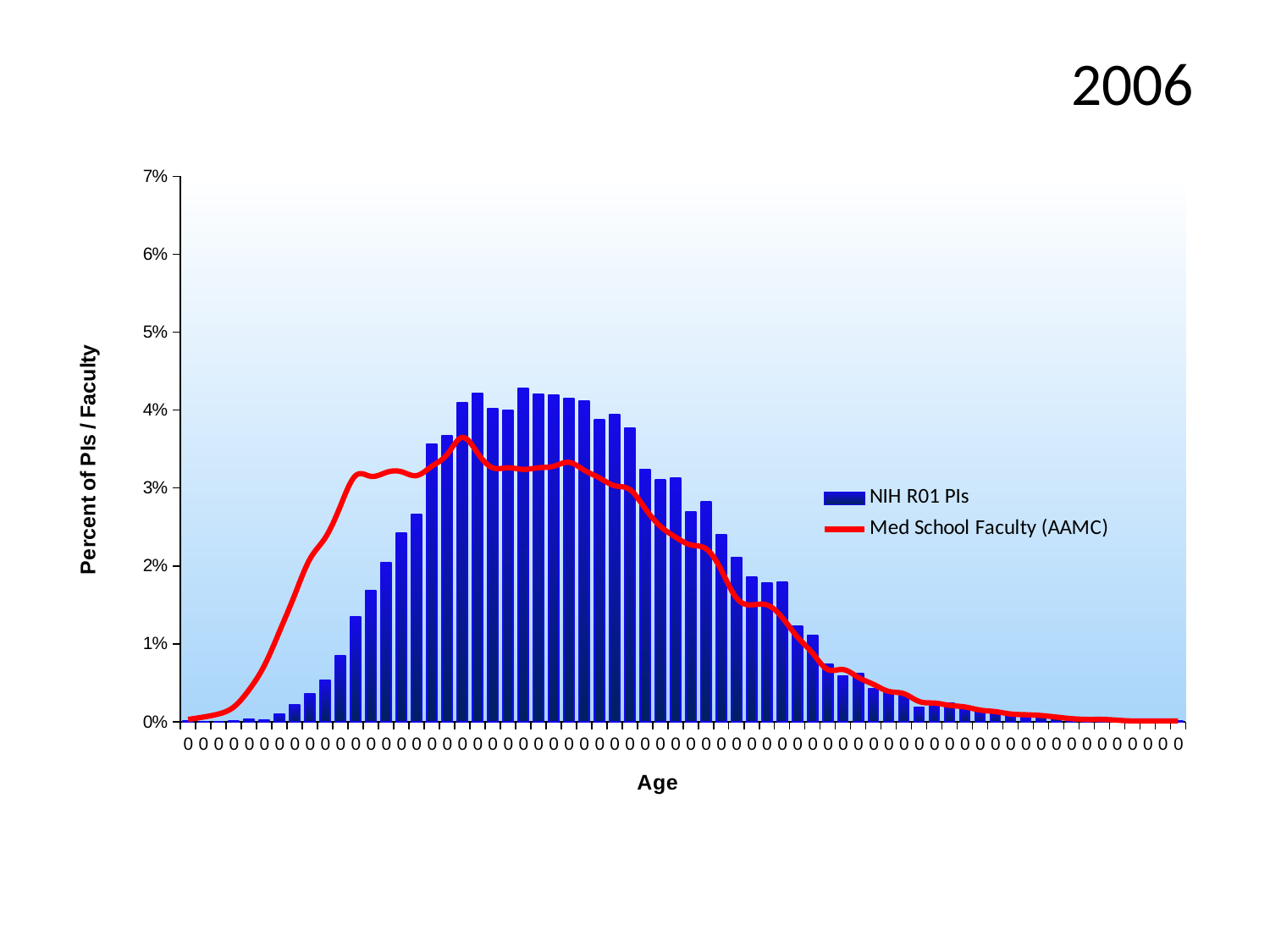
Is the peak of the Med School Faculty (AAMC) line greater or less than 3%? greater Which series is drawn as blue bars? NIH R01 PIs What kind of chart is shown on the slide? A bar chart with a line overlay Do the values of both series rise or fall toward the right end of the x axis? fall Is the highest value of the NIH R01 PIs bars greater or less than 4%? greater How many series does the legend list? 2 Which series reaches a higher peak value, NIH R01 PIs or Med School Faculty (AAMC)? NIH R01 PIs Which series is drawn as a red line? Med School Faculty (AAMC) What is the highest value shown on the y axis? 7% Is the peak of the Med School Faculty (AAMC) line greater or less than 4%? less